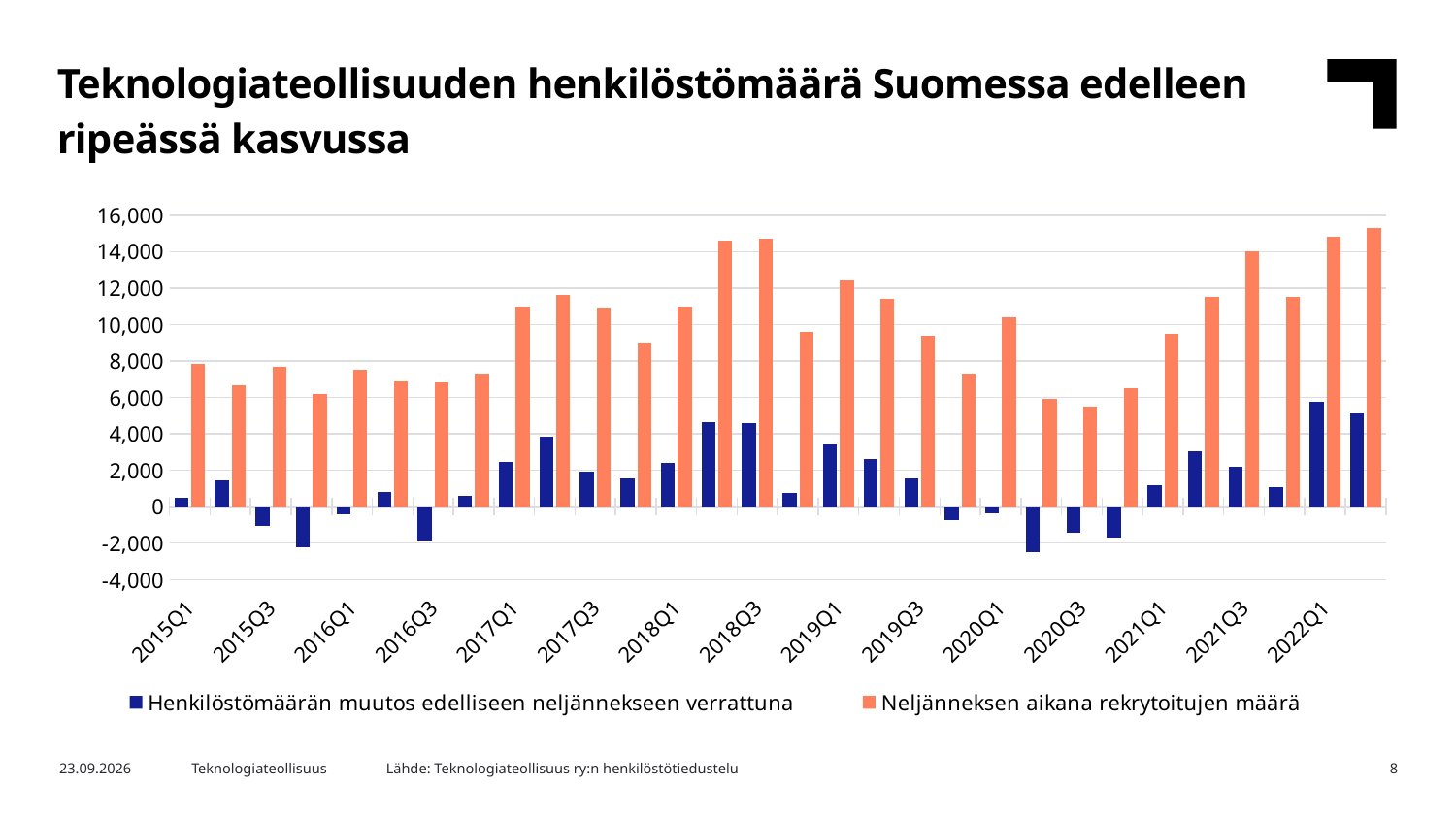
Is the value of 'Neljänneksen aikana rekrytoitujen määrä' for 2018Q3 greater or less than 12,000? greater Which series is shown in orange according to the legend? Neljänneksen aikana rekrytoitujen määrä Is the value of 'Henkilöstömäärän muutos edelliseen neljännekseen verrattuna' for 2022Q1 greater or less than 4,000? greater Which is larger for 'Henkilöstömäärän muutos edelliseen neljännekseen verrattuna': 2022Q1 or 2017Q1? 2022Q1 Is the value of 'Neljänneksen aikana rekrytoitujen määrä' for 2020Q3 greater or less than 6,000? less How many series does the legend list? 2 What kind of chart is shown on the slide? bar chart Which series is shown in dark blue according to the legend? Henkilöstömäärän muutos edelliseen neljännekseen verrattuna Do the values of 'Neljänneksen aikana rekrytoitujen määrä' generally rise or fall from 2020Q3 to 2022Q1? rise Which is larger for 'Neljänneksen aikana rekrytoitujen määrä': 2018Q3 or 2015Q1? 2018Q3